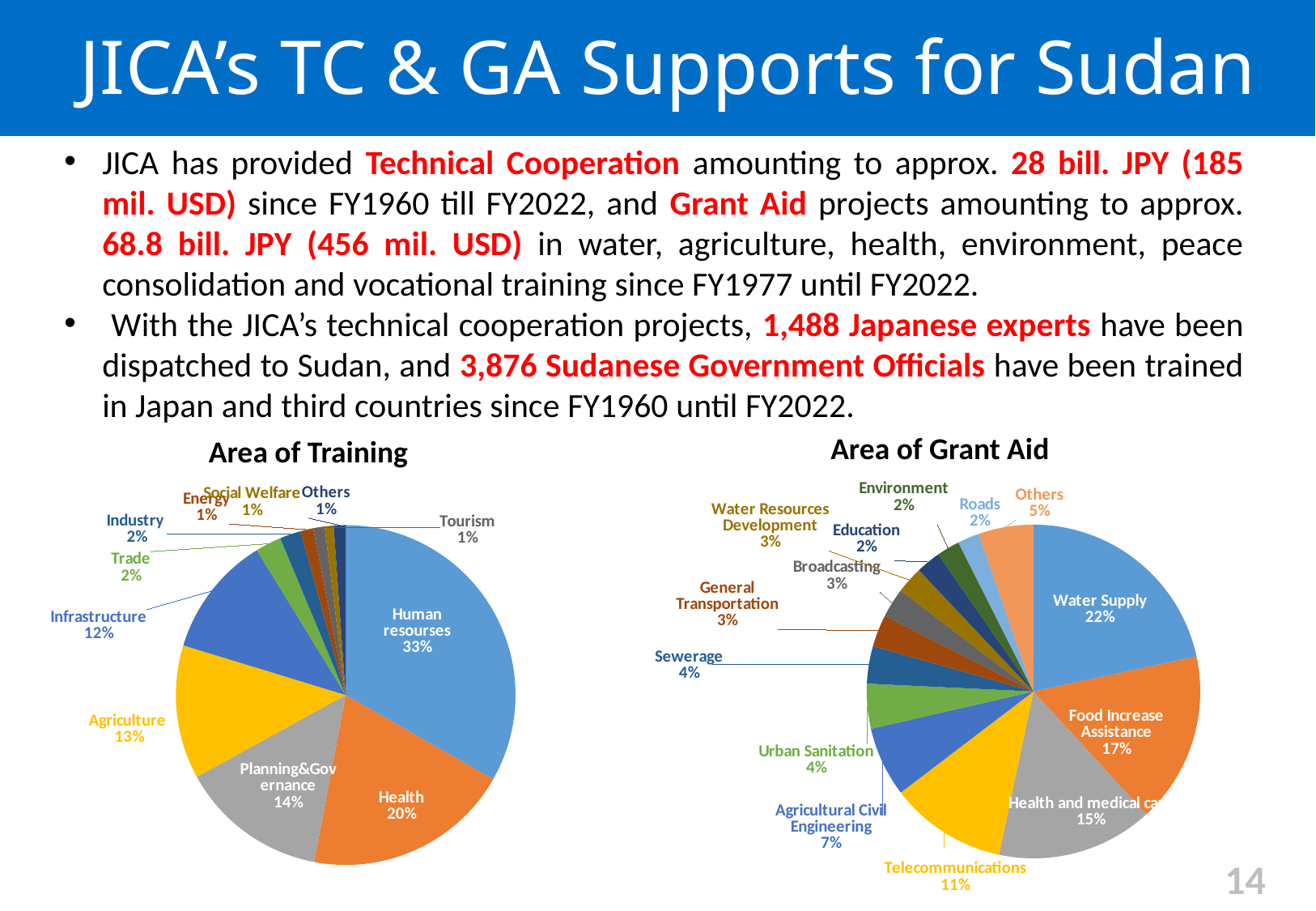
How many categories are shown in the Area of Grant Aid chart? 14 In the Area of Grant Aid chart, which area has the largest share? Water Supply In the Area of Grant Aid chart, what share does Telecommunications have? 11% In the Area of Training chart, what share does Human resourses have? 33% In the Area of Training chart, which is larger, Planning&Governance or Agriculture? Planning&Governance In the Area of Training chart, what is the difference between the Agriculture and Infrastructure shares? 1% How many categories are shown in the Area of Training chart? 11 In the Area of Grant Aid chart, what is the difference between the Food Increase Assistance and Health and medical care shares? 2% In the Area of Grant Aid chart, what share does Water Supply have? 22% What type of chart is the Area of Grant Aid chart? Pie chart In the Area of Training chart, what share does Health have? 20% In the Area of Training chart, which area has the largest share? Human resourses